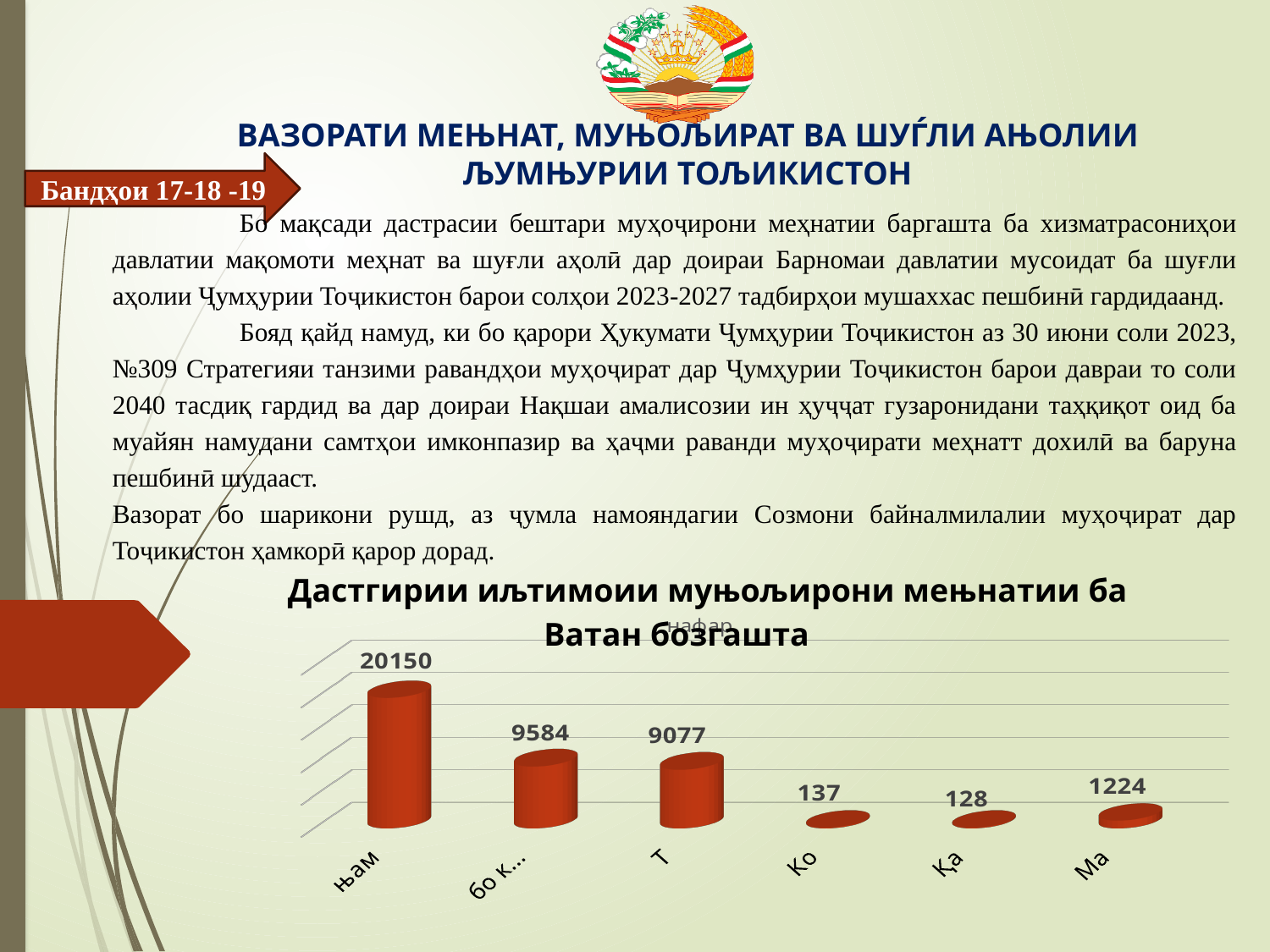
What type of chart is shown on the slide? bar chart What is the difference between the first bar (20150) and the second bar (9584)? 10566 Which bar has the highest value in the chart? the first bar (њам), 20150 How many bars (categories) does the chart show? 6 What is the value of the bar labelled "Т"? 9077 What is the value of the first (leftmost) bar in the chart? 20150 What is the difference between the values for "Ма" and "Ко"? 1087 Which bar has the lowest value in the chart? Қа, 128 Which is larger: the value for "бо к..." or the value for "Т"? бо к... (9584) What is the value of the last (rightmost) bar, labelled "Ма"? 1224 What is the value of the bar labelled "Ко"? 137 What is the title of the chart? Дастгирии иљтимоии муњољирони мењнатии ба Ватан бозгашта